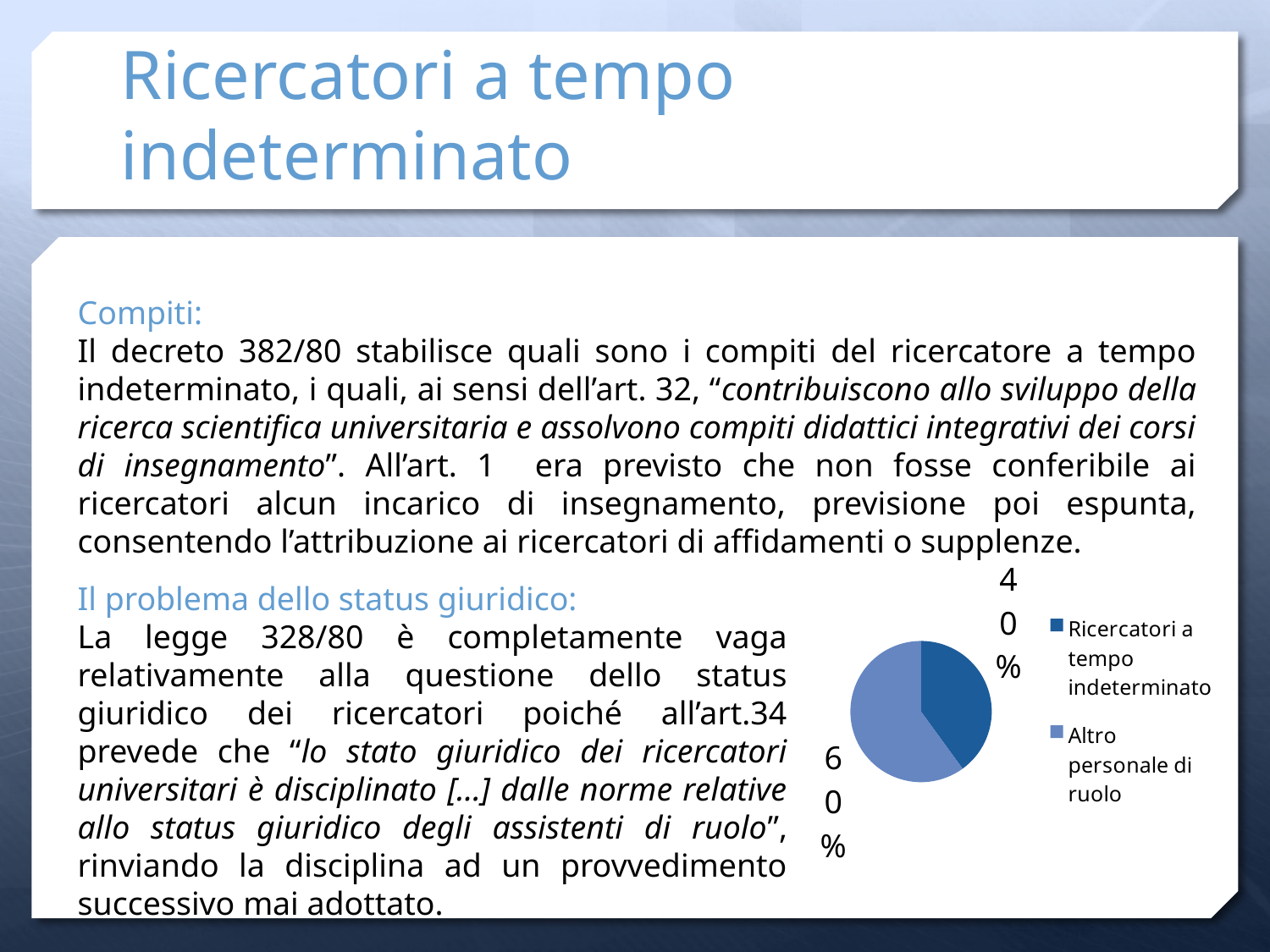
Which slice of the pie chart is the largest? Altro personale di ruolo What kind of chart is shown on the slide? pie chart Which is larger in the pie chart: "Ricercatori a tempo indeterminato" or "Altro personale di ruolo"? Altro personale di ruolo How many slices does the pie chart have? 2 Which legend entry is shown in the darker blue colour in the pie chart? Ricercatori a tempo indeterminato What share of the pie does the "Ricercatori a tempo indeterminato" slice represent? 40% What percentage does the pie chart show for "Altro personale di ruolo"? 60% What is the difference in percentage points between "Altro personale di ruolo" and "Ricercatori a tempo indeterminato" in the pie chart? 20 Which slice of the pie chart is the smallest? Ricercatori a tempo indeterminato What percentage does the pie chart show for "Ricercatori a tempo indeterminato"? 40% Where is the legend positioned relative to the pie chart? to the right How many entries does the legend of the pie chart list? 2